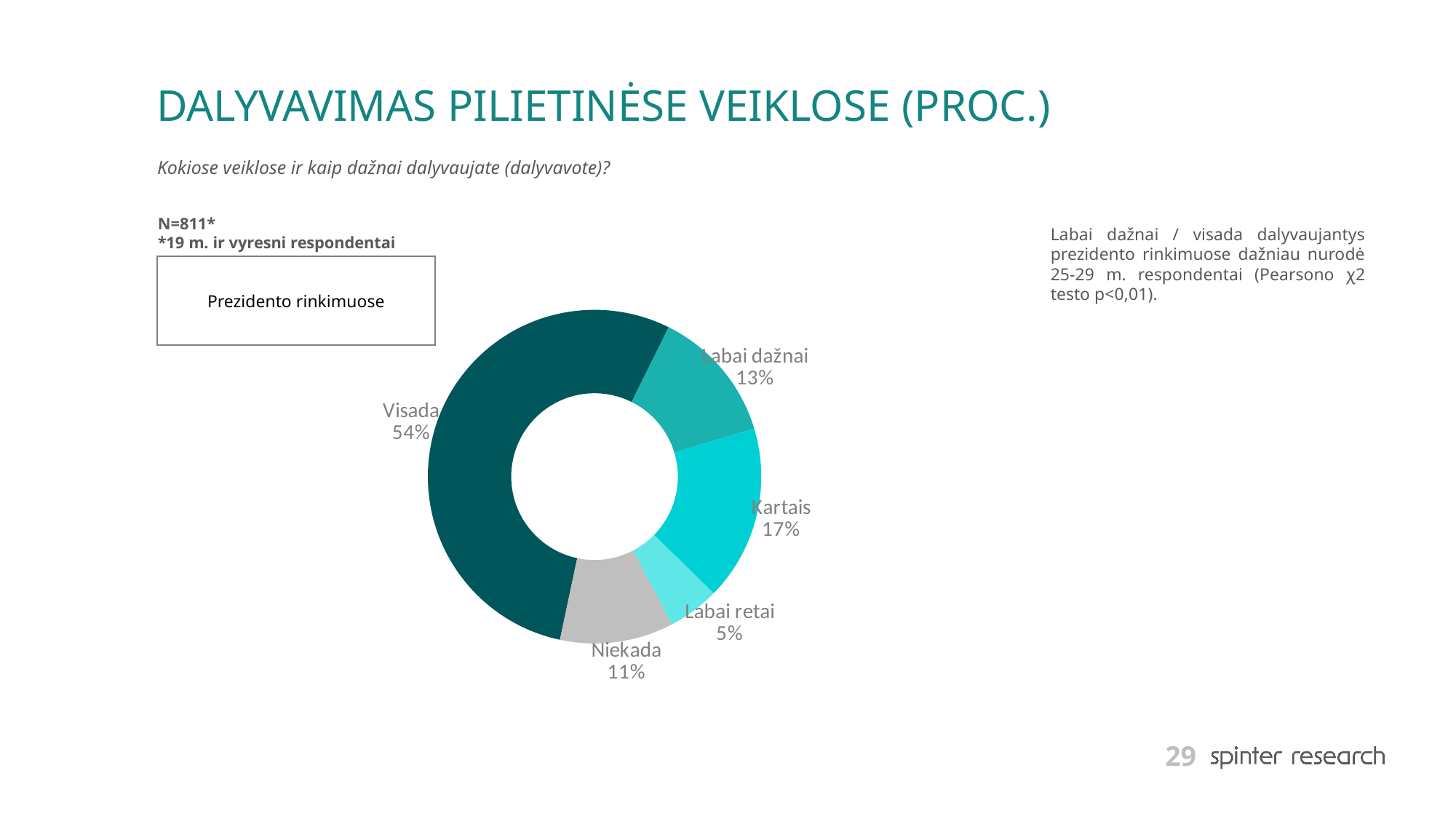
What percentage of respondents answered "Niekada"? 11% What percentage of respondents answered "Visada" for participation in presidential elections? 54% What percentage of respondents answered "Labai retai"? 5% What kind of chart is shown on the slide? Pie chart (doughnut) What is the combined share of "Labai dažnai" and "Visada"? 67% Which category has the smallest share of the pie? Labai retai How many categories are shown in the chart? 5 Which category has the largest share of the pie? Visada What percentage of respondents answered "Kartais"? 17% What activity does the chart refer to, according to the box above it? Prezidento rinkimuose Which is larger, the share for "Labai dažnai" or the share for "Niekada"? Labai dažnai What is the difference in percentage points between "Visada" and "Kartais"? 37